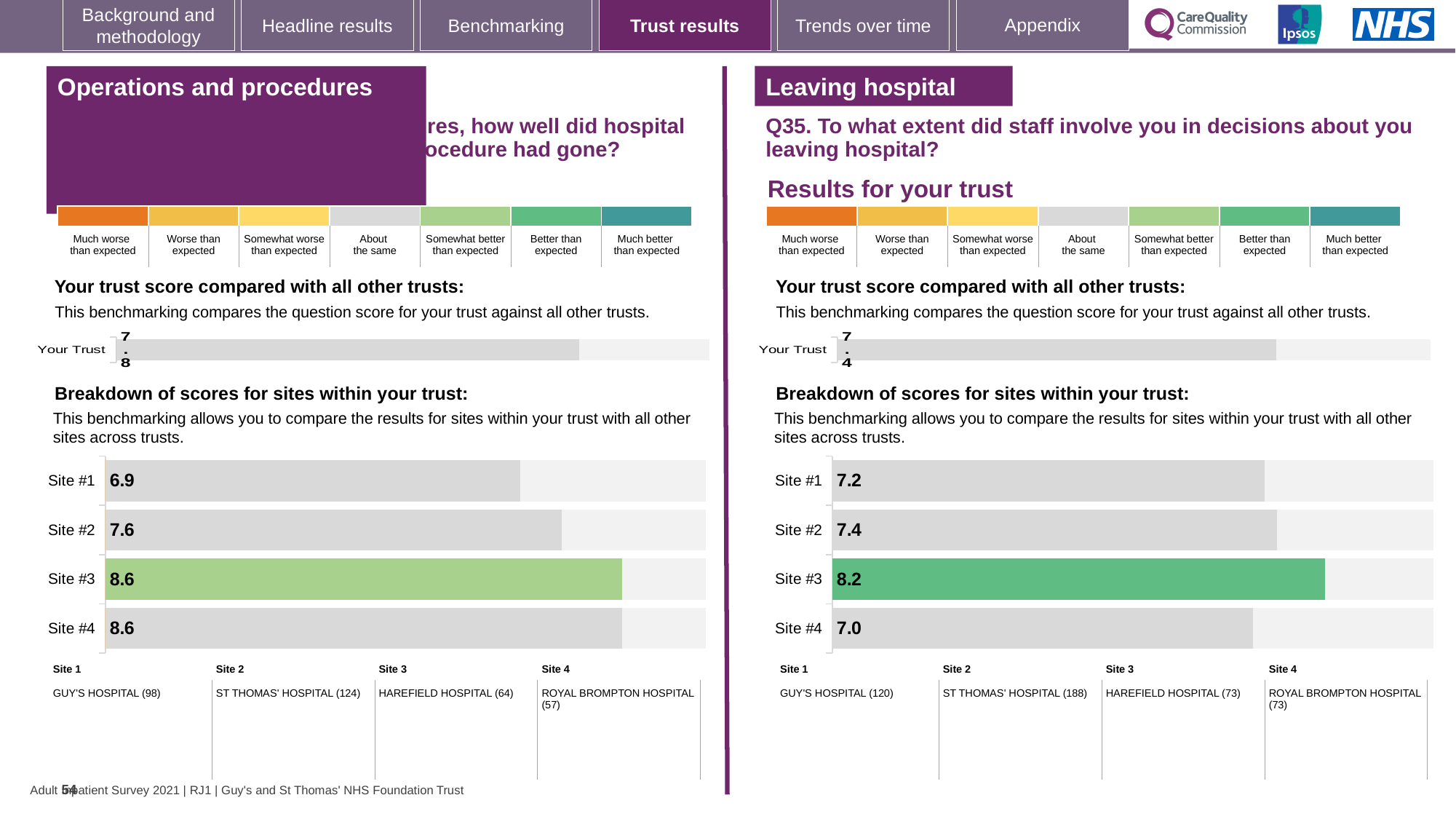
What is the 'Your Trust' score shown in the Leaving hospital section on the right? 7.4 How many sites are shown in the Operations and procedures site breakdown chart on the left? 4 In the Operations and procedures site breakdown chart on the left, what is the score for Site #1? 6.9 In the Leaving hospital site breakdown chart on the right, which site has the highest score? Site #3 What type of chart is used for the breakdown of scores for sites within your trust? Bar chart In the Leaving hospital site breakdown chart on the right, what is the score for Site #3? 8.2 In the Leaving hospital site breakdown chart on the right, what is the difference between the scores for Site #3 and Site #4? 1.2 What is the 'Your Trust' score shown in the Operations and procedures section on the left? 7.8 In the Operations and procedures site breakdown chart on the left, which site has the lowest score? Site #1 In the Leaving hospital site breakdown chart on the right, which site has the lowest score? Site #4 In the Operations and procedures site breakdown chart on the left, what is the difference between the scores for Site #3 and Site #1? 1.7 In the Leaving hospital site breakdown chart on the right, which is larger, the score for Site #2 or Site #1? Site #2